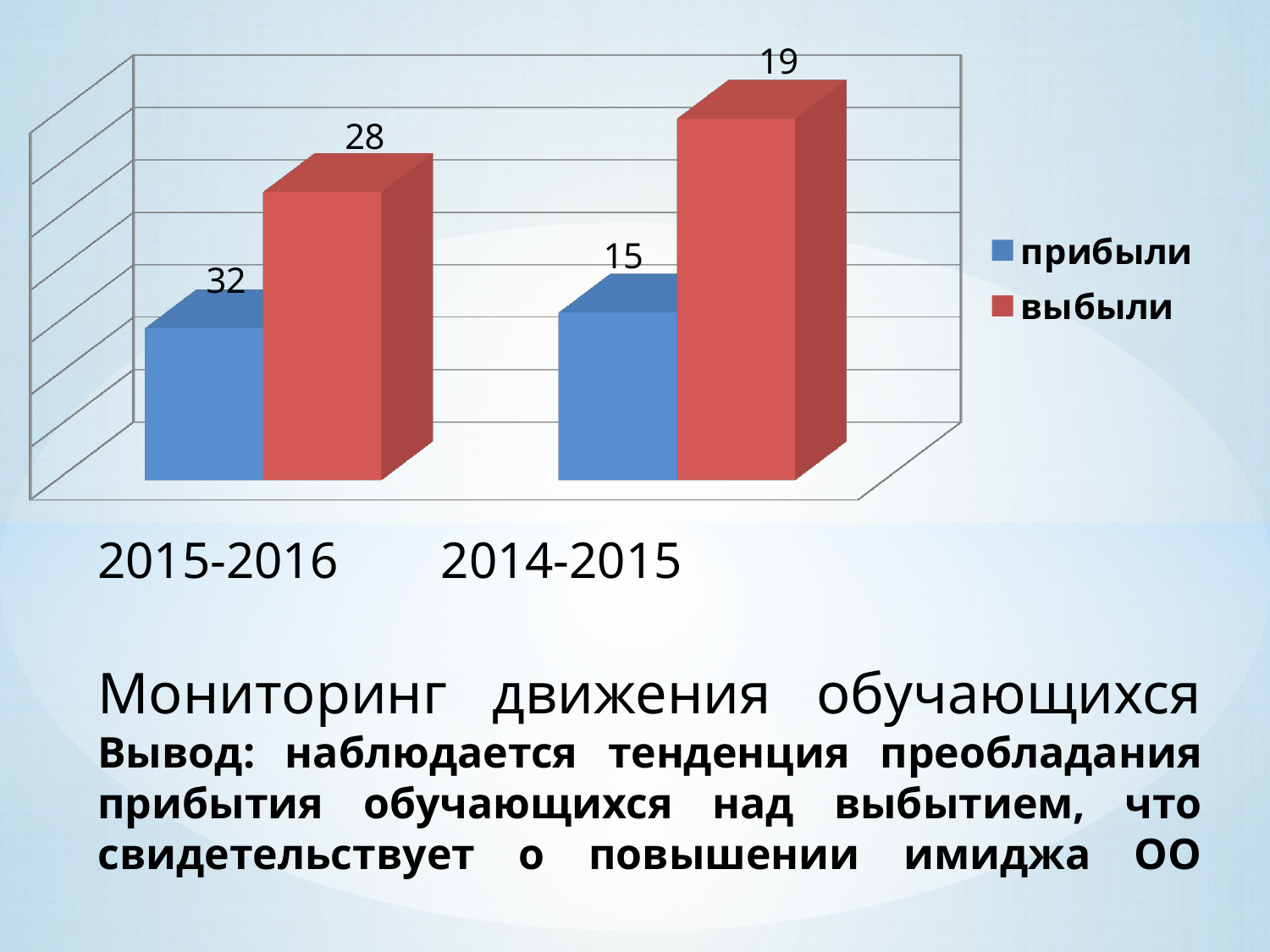
In 2014-2015, which is larger: прибыли or выбыли? выбыли What is the value for прибыли in 2014-2015? 15 How many series does the legend list? 2 What is the value for прибыли in 2015-2016? 32 How many categories (periods) are shown on the x axis? 2 What is the difference between выбыли and прибыли in 2014-2015? 4 What is the difference between прибыли and выбыли in 2015-2016? 4 What is the value for выбыли in 2015-2016? 28 What is the difference between прибыли in 2015-2016 and прибыли in 2014-2015? 17 Which series is shown in red in the legend? выбыли What kind of chart is shown on the slide? bar chart What is the value for выбыли in 2014-2015? 19